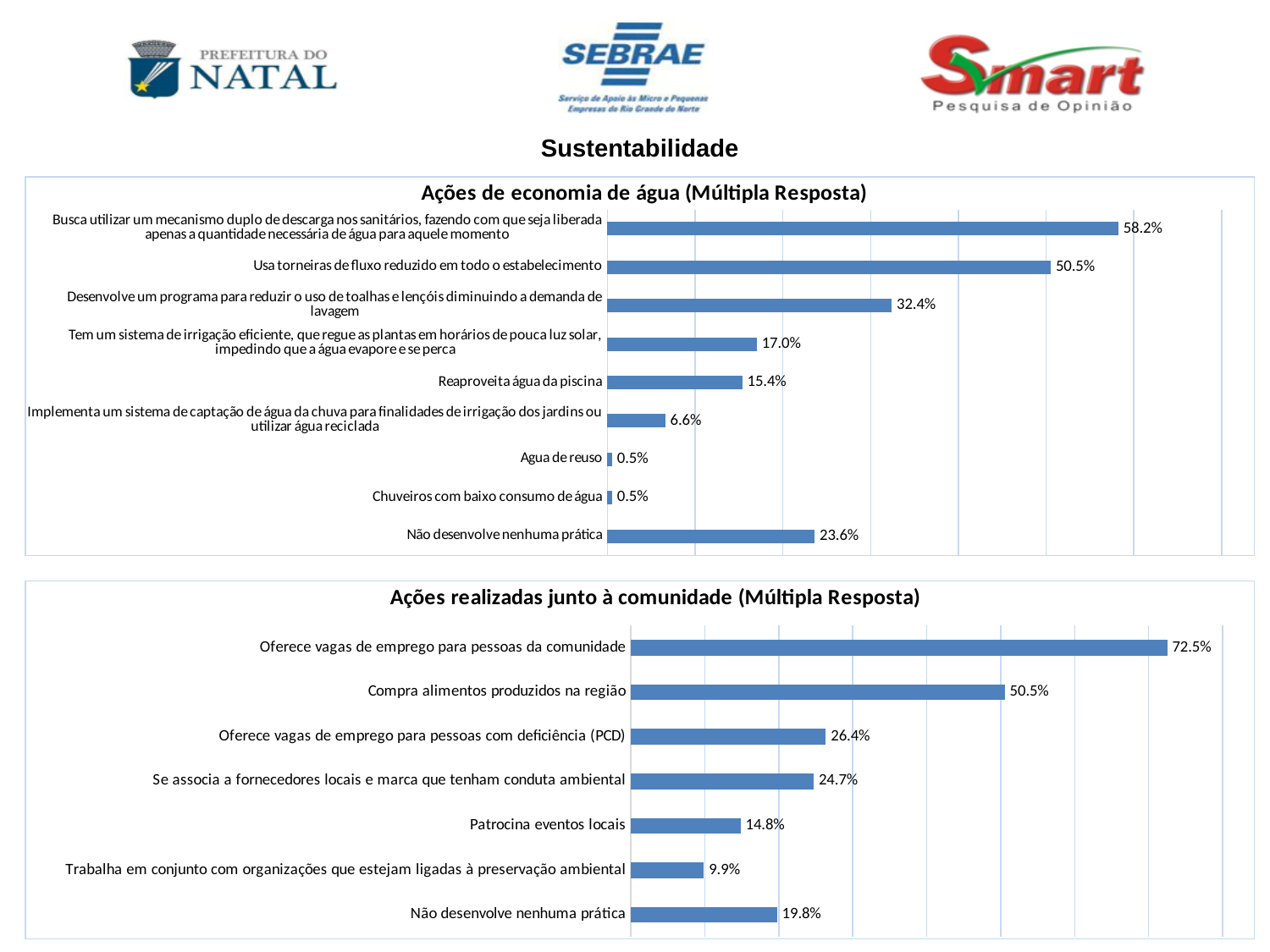
In the chart 'Ações de economia de água (Múltipla Resposta)', which category has the highest value? Busca utilizar um mecanismo duplo de descarga nos sanitários, fazendo com que seja liberada apenas a quantidade necessária de água para aquele momento In the chart 'Ações de economia de água (Múltipla Resposta)', what is the value for 'Não desenvolve nenhuma prática'? 23.6% In the chart 'Ações realizadas junto à comunidade (Múltipla Resposta)', what is the value for 'Patrocina eventos locais'? 14.8% How many categories are shown in the chart 'Ações de economia de água (Múltipla Resposta)'? 9 In the chart 'Ações realizadas junto à comunidade (Múltipla Resposta)', which category has the lowest value? Trabalha em conjunto com organizações que estejam ligadas à preservação ambiental In the chart 'Ações realizadas junto à comunidade (Múltipla Resposta)', what is the difference between 'Compra alimentos produzidos na região' and 'Oferece vagas de emprego para pessoas com deficiência (PCD)'? 24.1% In the chart 'Ações de economia de água (Múltipla Resposta)', what is the value for 'Usa torneiras de fluxo reduzido em todo o estabelecimento'? 50.5% In the chart 'Ações de economia de água (Múltipla Resposta)', which is larger: 'Desenvolve um programa para reduzir o uso de toalhas e lençóis diminuindo a demanda de lavagem' or 'Tem um sistema de irrigação eficiente, que regue as plantas em horários de pouca luz solar, impedindo que a água evapore e se perca'? Desenvolve um programa para reduzir o uso de toalhas e lençóis diminuindo a demanda de lavagem What type of chart is 'Ações realizadas junto à comunidade (Múltipla Resposta)'? Bar chart In the chart 'Ações de economia de água (Múltipla Resposta)', what is the difference between 'Reaproveita água da piscina' and 'Implementa um sistema de captação de água da chuva para finalidades de irrigação dos jardins ou utilizar água reciclada'? 8.8% In the chart 'Ações realizadas junto à comunidade (Múltipla Resposta)', what is the value for 'Oferece vagas de emprego para pessoas da comunidade'? 72.5% How many categories are shown in the chart 'Ações realizadas junto à comunidade (Múltipla Resposta)'? 7